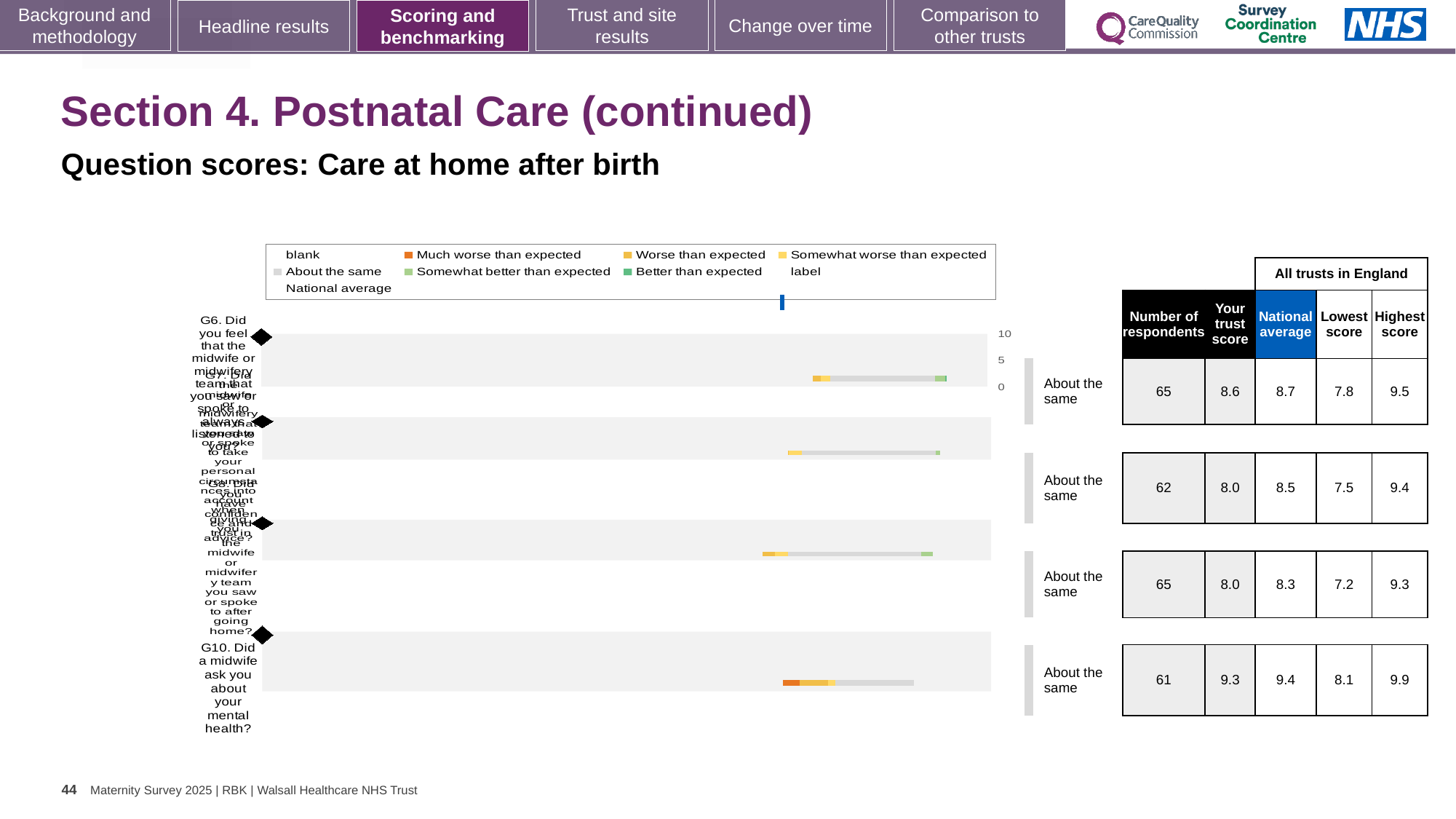
What colour represents 'Much worse than expected' in the legend? orange How many question rows (bars) are plotted in the chart? 4 What kind of chart is shown on the slide? bar chart In the table, what is the number of respondents for G10 (Did a midwife ask you about your mental health?)? 61 In the table, what is the highest score for the second row? 9.4 In the table, what is the national average for the first row (G6)? 8.7 What benchmark category is shown for all four questions? About the same In the table, what is the trust score for G10 (Did a midwife ask you about your mental health?)? 9.3 What is the difference between the highest score and the lowest score for G10? 1.8 Which question row has the highest trust score in the table? G10 Which is larger: the trust score for the first row (G6) or the trust score for the second row? the first row (G6), 8.6 Which row has the lowest value in the 'Lowest score' column? the third row (7.2)